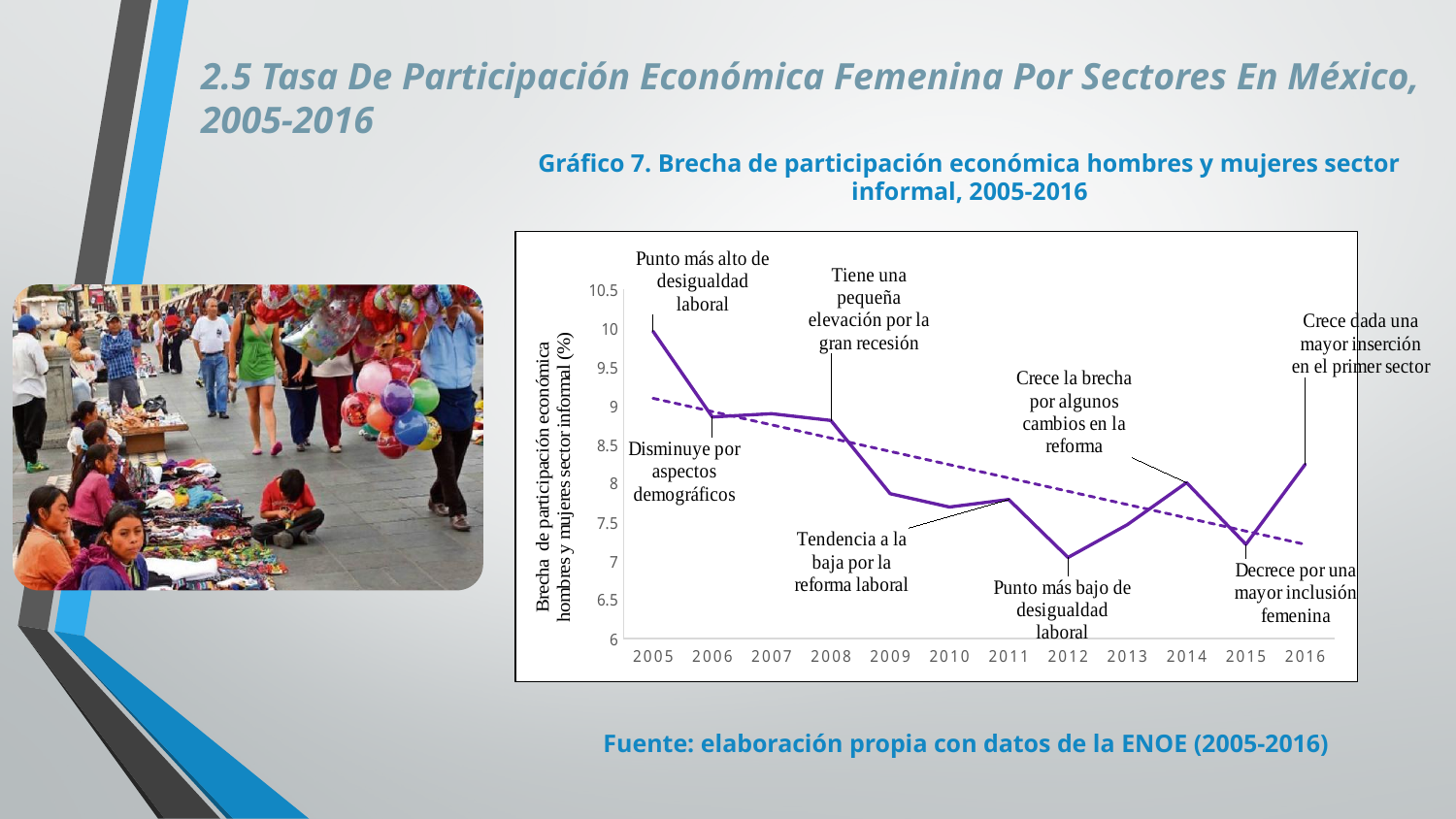
Which year has the lowest value in the chart? 2012 Is the value for 2016 greater or less than 8? greater Which year has the highest value in the chart? 2005 What is the title of the chart? Gráfico 7. Brecha de participación económica hombres y mujeres sector informal, 2005-2016 Is the value for 2012 greater or less than 7.5? less Does the dashed trend line rise or fall from 2005 to 2016? Fall Is the value for 2005 greater or less than 9.5? greater Which is larger, the value for 2012 or the value for 2014? 2014 How many years are plotted along the x axis? 12 Which is larger, the value for 2005 or the value for 2016? 2005 What kind of chart is shown on the slide? Line chart